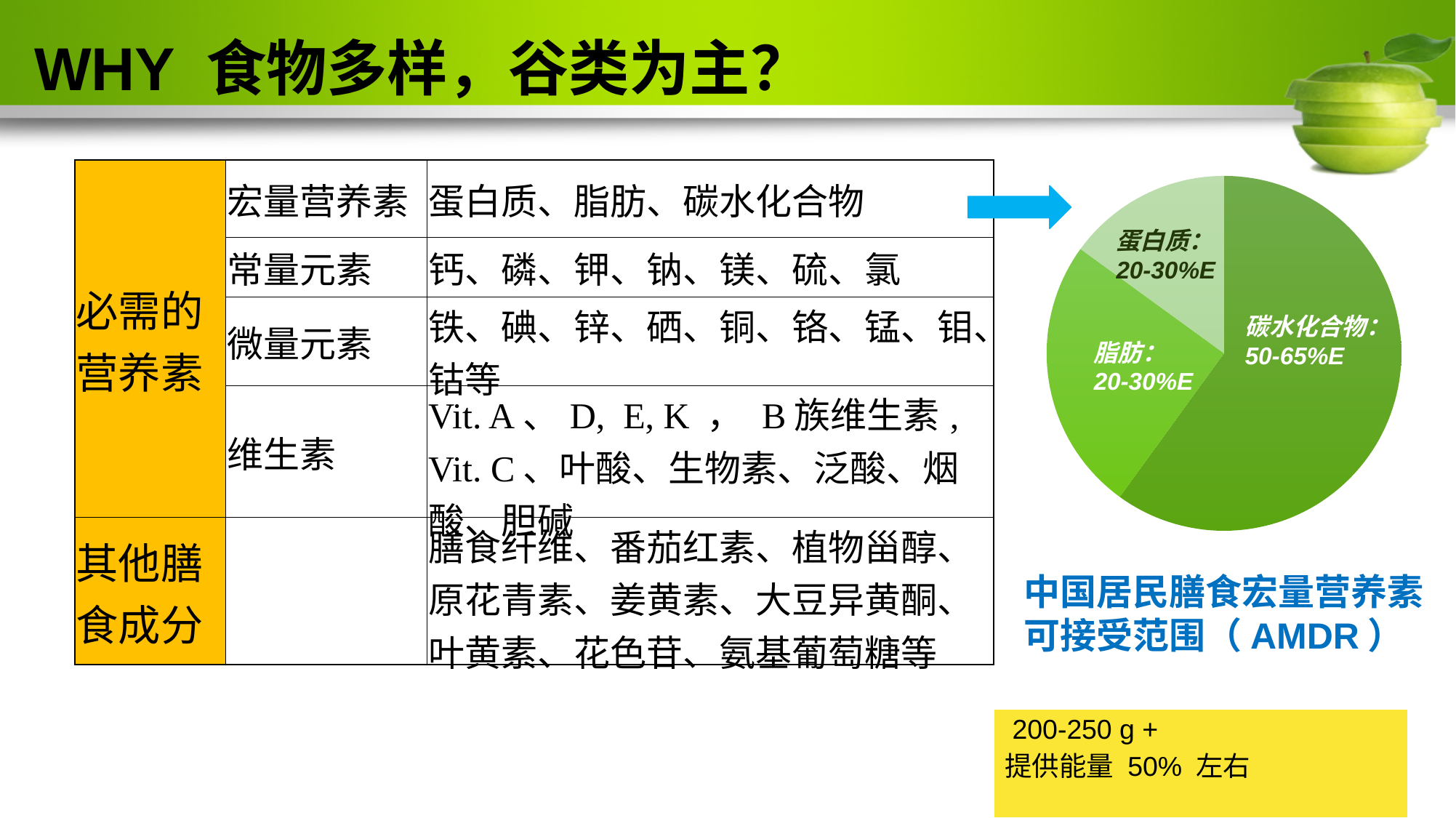
In the pie chart, which has the larger share: 蛋白质 or 碳水化合物? 碳水化合物 In the pie chart, what range is shown for 脂肪? 20-30%E Which macronutrient in the pie chart is labelled with the range 50-65%E? 碳水化合物 In the pie chart, which has the larger share: 碳水化合物 or 脂肪? 碳水化合物 Which slice of the pie chart is the largest? 碳水化合物 What kind of chart is shown on the right side of the slide? pie chart In the pie chart, what range is shown for 蛋白质? 20-30%E How many slices does the pie chart have? 3 In the pie chart, what range is shown for 碳水化合物? 50-65%E What is the title printed below the pie chart? 中国居民膳食宏量营养素可接受范围（AMDR）